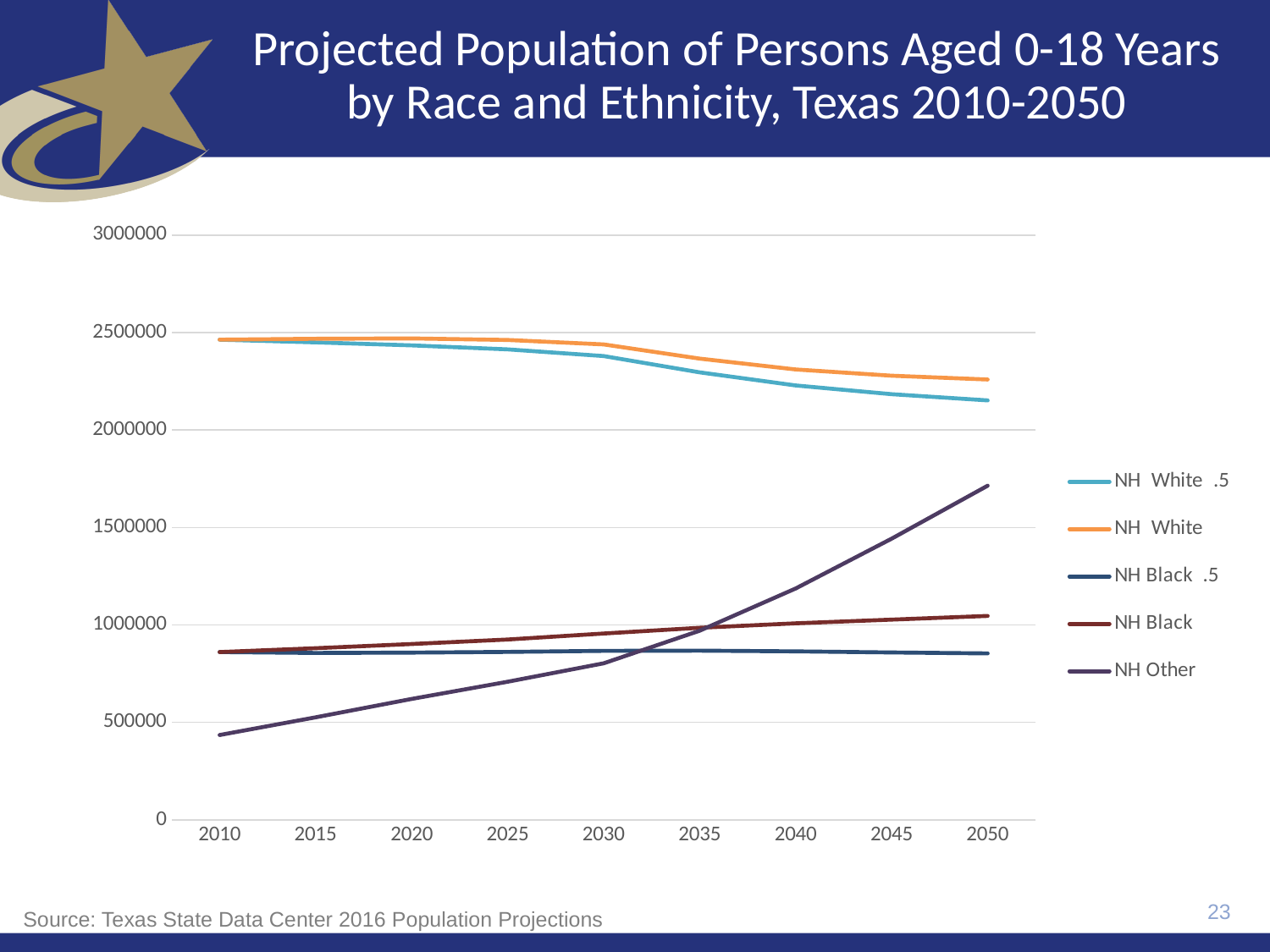
Is the value for NH Other in 2010 greater or less than 500000? less Which series has the lowest value in 2010? NH Other Which series has the lowest value in 2050? NH Black .5 Which series has the highest value in 2050? NH White In 2050, which is larger: NH Other or NH Black? NH Other How many series does the legend list? 5 Does the NH Other line rise or fall from 2010 to 2050? rise What is the source cited at the bottom of the slide? Texas State Data Center 2016 Population Projections Is the value for NH Other in 2050 greater or less than 1500000? greater What kind of chart is shown on the slide? line chart How many years are marked along the x axis? 9 Does the NH White line rise or fall from 2010 to 2050? fall